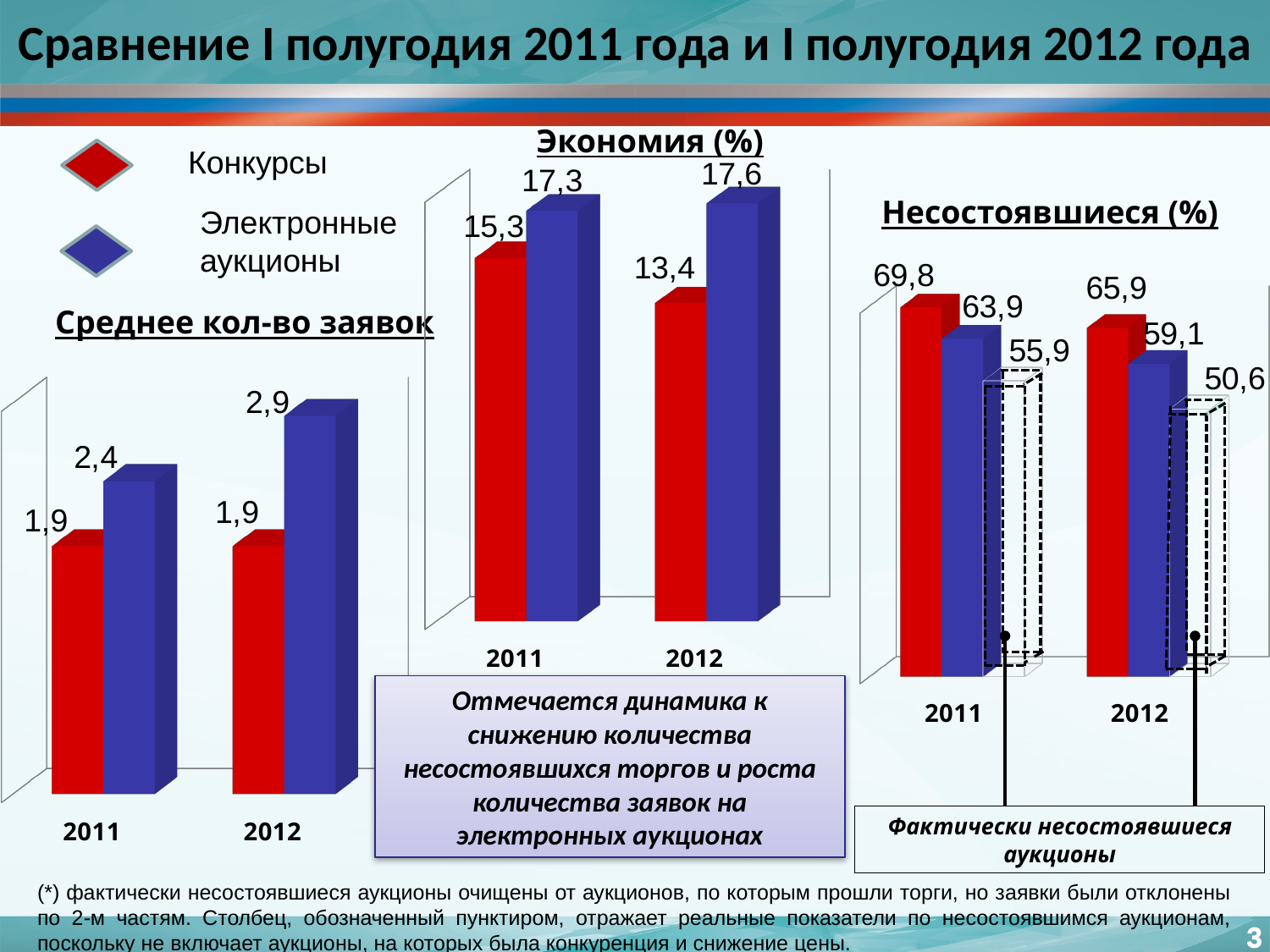
Which series does the red colour represent in the legend? Конкурсы In the chart 'Экономия (%)', what is the difference between the Электронные аукционы value and the Конкурсы value in 2012? 4,2 In the chart 'Экономия (%)', what is the value for Электронные аукционы in 2011? 17,3 In the chart 'Экономия (%)', what is the value for Конкурсы in 2012? 13,4 In the chart 'Несостоявшиеся (%)', what is the value of the dashed bar (Фактически несостоявшиеся аукционы) for 2012? 50,6 What type of chart is 'Экономия (%)'? bar chart In the chart 'Среднее кол-во заявок', what is the value for Электронные аукционы in 2012? 2,9 In the chart 'Несостоявшиеся (%)', what is the value for Конкурсы in 2011? 69,8 In the chart 'Среднее кол-во заявок', does the Электронные аукционы value rise or fall from 2011 to 2012? rise In the chart 'Несостоявшиеся (%)', does the Конкурсы value rise or fall from 2011 to 2012? fall In the chart 'Несостоявшиеся (%)', which is larger in 2012: Конкурсы or Электронные аукционы? Конкурсы In the chart 'Среднее кол-во заявок', what is the value for Конкурсы in 2011? 1,9